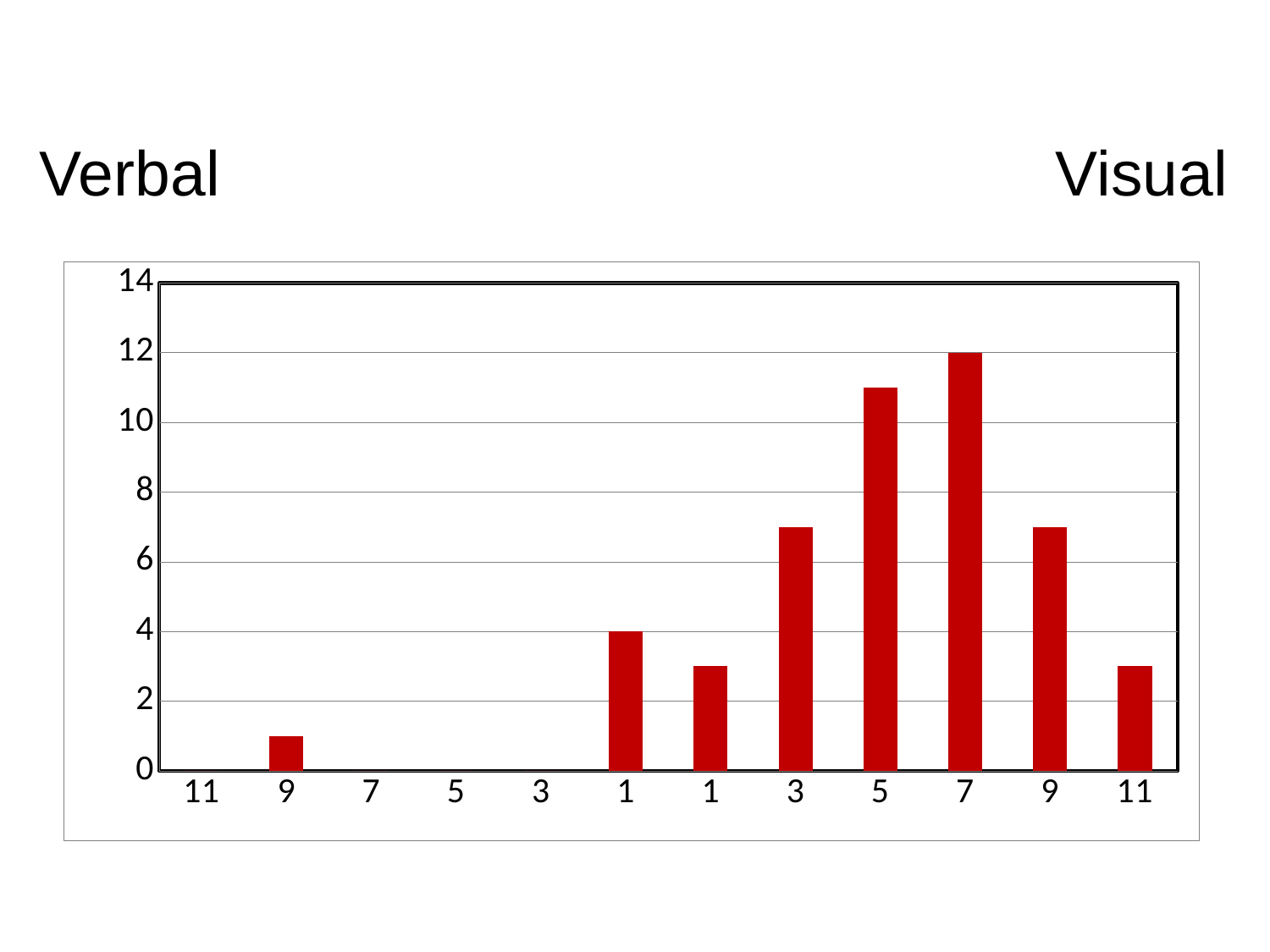
What is the value of the bar for category 1 on the Verbal side? 4 What is the difference between the bar for 7 on the Visual side and the bar for 1 on the Verbal side? 8 Which is larger: the bar for 5 on the Visual side or the bar for 9 on the Visual side? 5 on the Visual side What colour are the bars in the chart? red Is the value for category 3 on the Visual side greater or less than 8? less Which category has the tallest bar in the chart? 7 on the Visual side What is the value of the bar for category 7 on the Visual side? 12 Is the value for category 5 on the Visual side greater or less than 10? greater Is the value for category 9 on the Verbal side greater or less than 2? less How many categories are shown along the x axis of the chart? 12 What kind of chart is shown on the slide? bar chart Moving from category 7 to category 11 on the Visual side, do the bar values rise or fall? fall